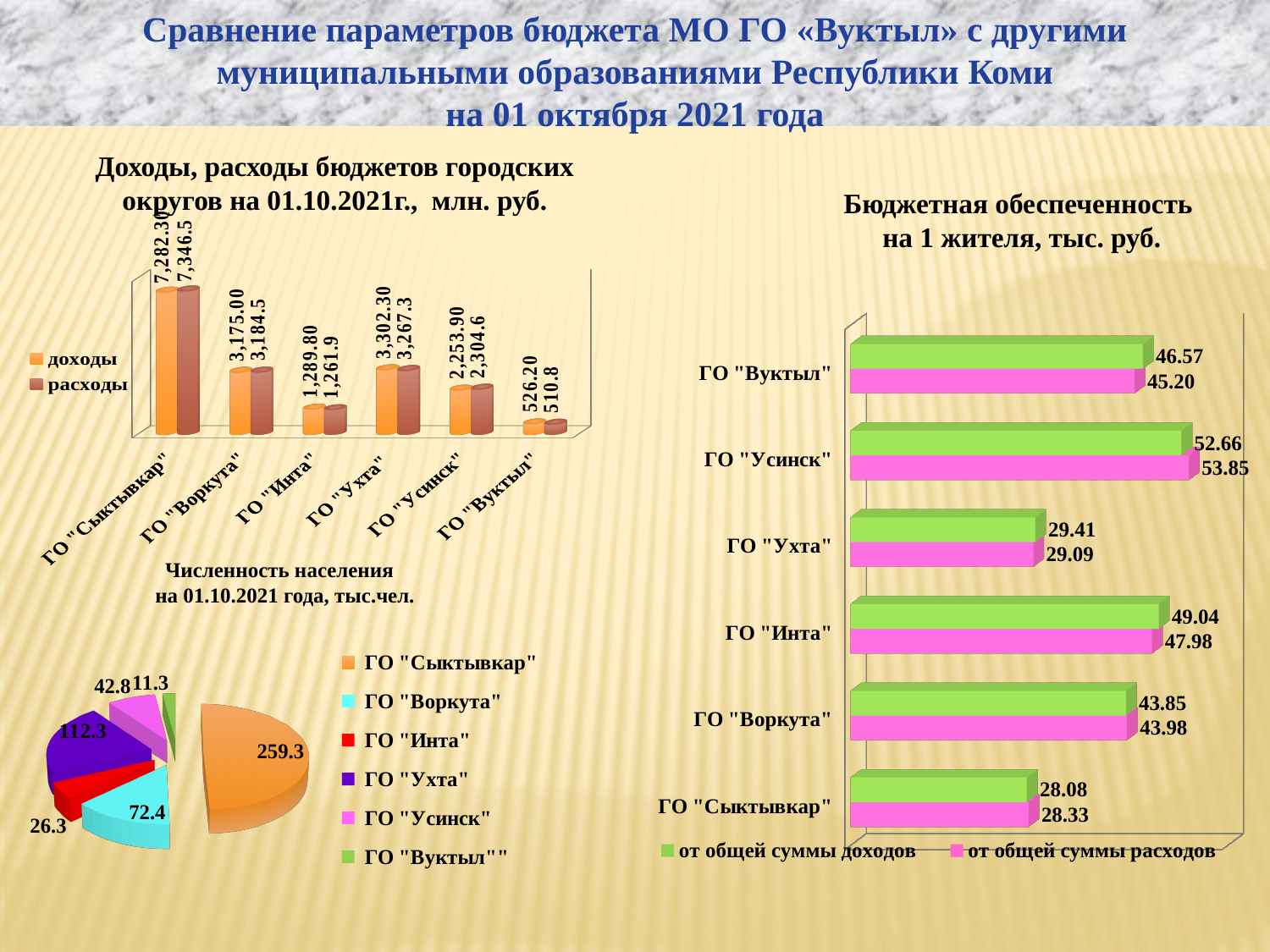
In the pie chart 'Численность населения на 01.10.2021 года, тыс.чел.', which city district has the smallest population? ГО "Вуктыл" What kind of chart is 'Бюджетная обеспеченность на 1 жителя, тыс. руб.'? Bar chart In the pie chart 'Численность населения на 01.10.2021 года, тыс.чел.', what is the value for ГО "Ухта"? 112.3 What kind of chart is 'Численность населения на 01.10.2021 года, тыс.чел.'? Pie chart In the chart 'Доходы, расходы бюджетов городских округов на 01.10.2021г., млн. руб.', how many city districts are shown? 6 In the chart 'Бюджетная обеспеченность на 1 жителя, тыс. руб.', what is the difference between the 'от общей суммы доходов' values for ГО "Усинск" and ГО "Сыктывкар"? 24.58 In the chart 'Доходы, расходы бюджетов городских округов на 01.10.2021г., млн. руб.', which city district has the highest доходы? ГО "Сыктывкар" In the chart 'Доходы, расходы бюджетов городских округов на 01.10.2021г., млн. руб.', what is the доходы value for ГО "Вуктыл"? 526.20 In the chart 'Бюджетная обеспеченность на 1 жителя, тыс. руб.', which city district has the highest value 'от общей суммы расходов'? ГО "Усинск" In the chart 'Доходы, расходы бюджетов городских округов на 01.10.2021г., млн. руб.', what is the расходы value for ГО "Сыктывкар"? 7,346.5 In the chart 'Доходы, расходы бюджетов городских округов на 01.10.2021г., млн. руб.', how many series does the legend list? 2 In the chart 'Бюджетная обеспеченность на 1 жителя, тыс. руб.', what is the value 'от общей суммы доходов' for ГО "Вуктыл"? 46.57